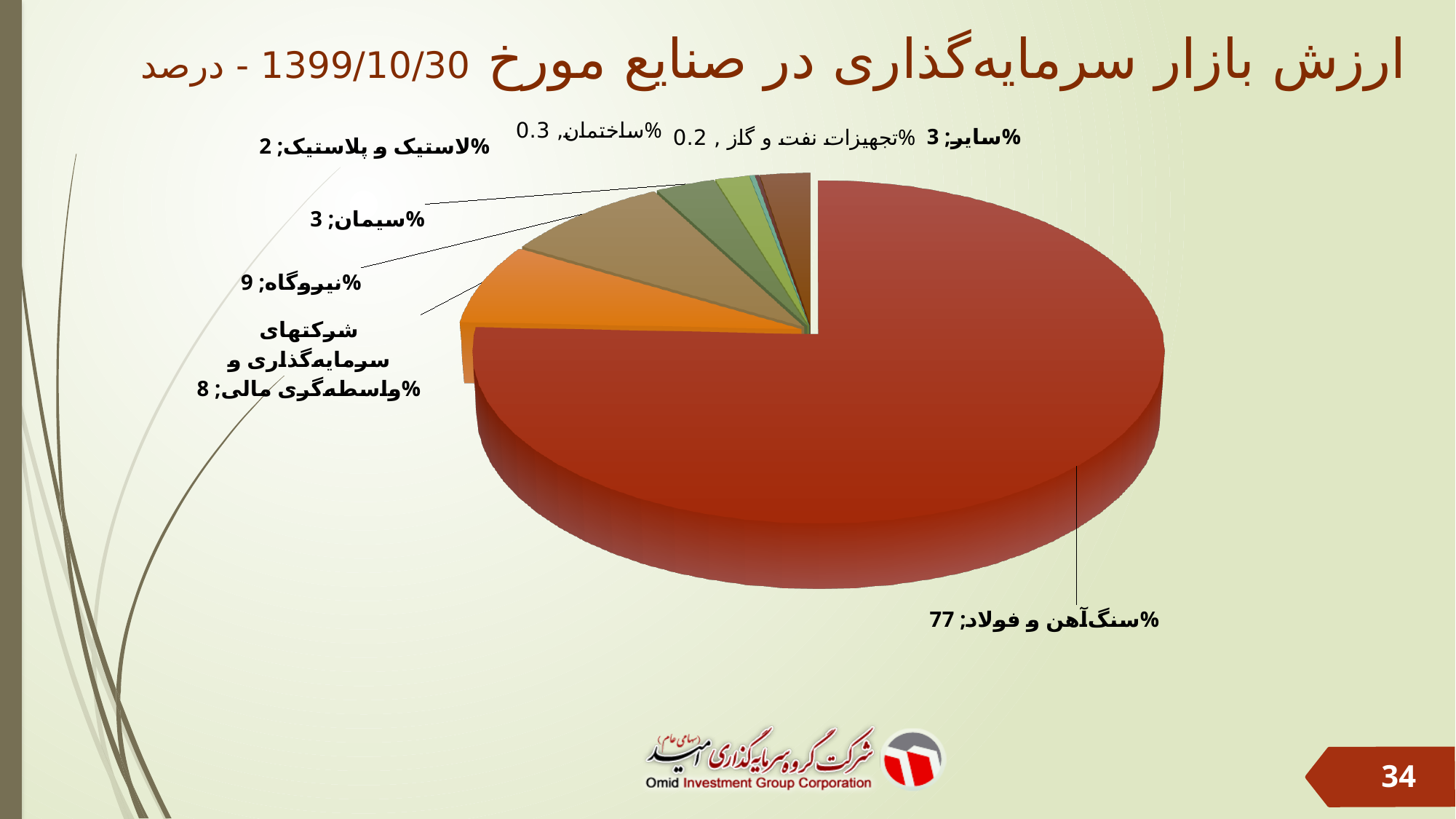
How many categories (slices) does the pie chart have? 8 What is the value for لاستیک و پلاستیک (rubber and plastics)? 2% What is the value for ساختمان (construction)? 0.3% What kind of chart is shown on the slide? pie chart What is the value for شرکتهای سرمایه‌گذاری و واسطه‌گری مالی (investment and financial intermediation companies)? 8% What is the value for سنگ‌آهن و فولاد (iron ore and steel)? 77% Which category has the smallest share of the pie? تجهیزات نفت و گاز What is the value for نیروگاه (power plants)? 9% What is the value for تجهیزات نفت و گاز (oil and gas equipment)? 0.2% Which category has the largest share of the pie? سنگ‌آهن و فولاد What is the value for سیمان (cement)? 3% What is the difference between the values for نیروگاه and شرکتهای سرمایه‌گذاری و واسطه‌گری مالی? 1%